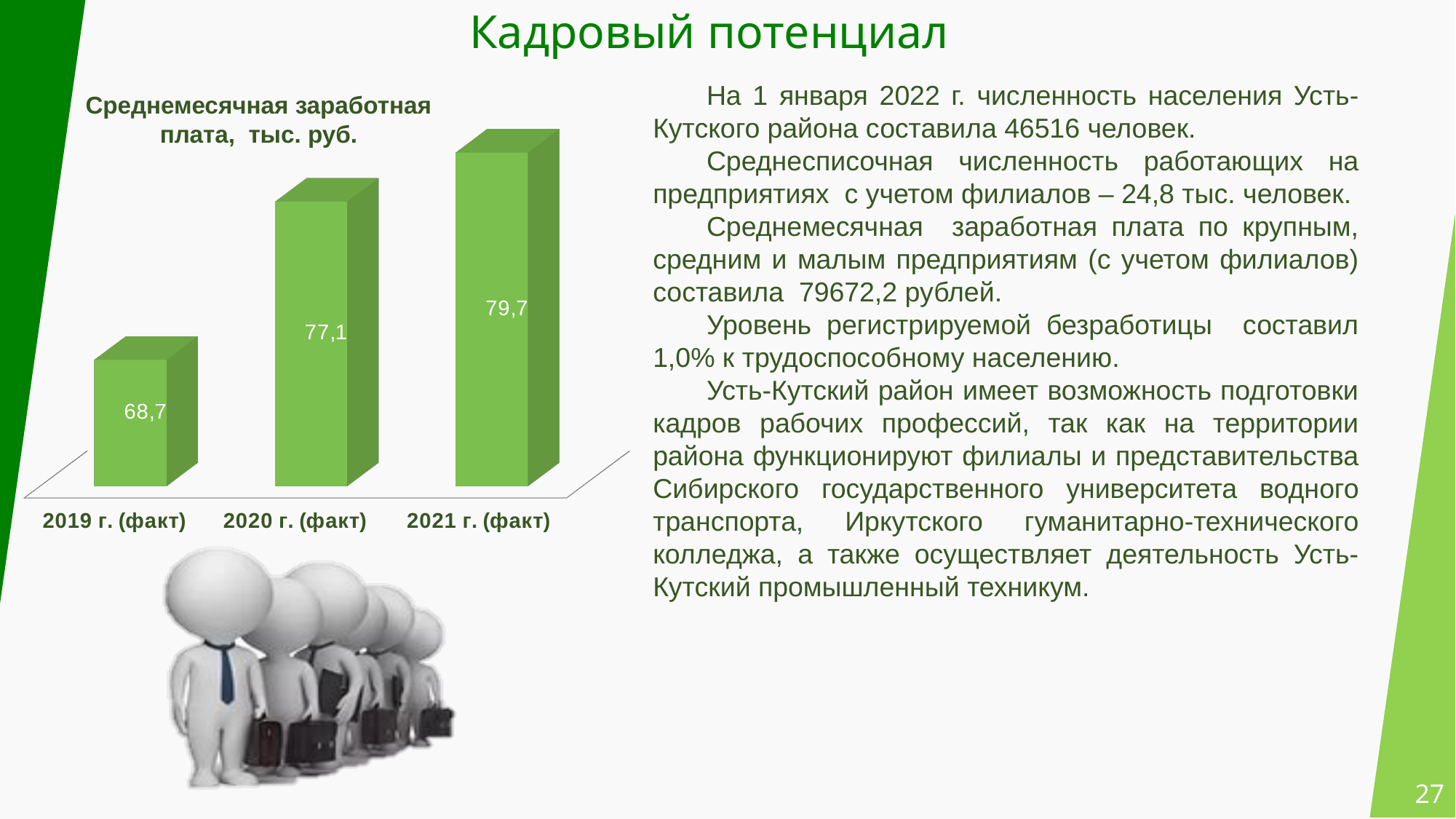
What is the value for 2021 г. (факт) in the chart? 79,7 How many categories (years) are shown in the chart? 3 Which year has the highest average monthly salary in the chart? 2021 г. (факт) What is the difference between the values for 2021 г. (факт) and 2020 г. (факт)? 2,6 What kind of chart is shown on the slide? Bar chart What is the difference between the values for 2020 г. (факт) and 2019 г. (факт)? 8,4 What is the value for 2019 г. (факт) in the chart? 68,7 Do the values rise or fall from 2019 to 2021 in the chart? Rise Which is larger: the value for 2020 г. (факт) or the value for 2019 г. (факт)? 2020 г. (факт) Which year has the lowest average monthly salary in the chart? 2019 г. (факт) What is the value for 2020 г. (факт) in the chart? 77,1 What is the difference between the values for 2021 г. (факт) and 2019 г. (факт)? 11,0